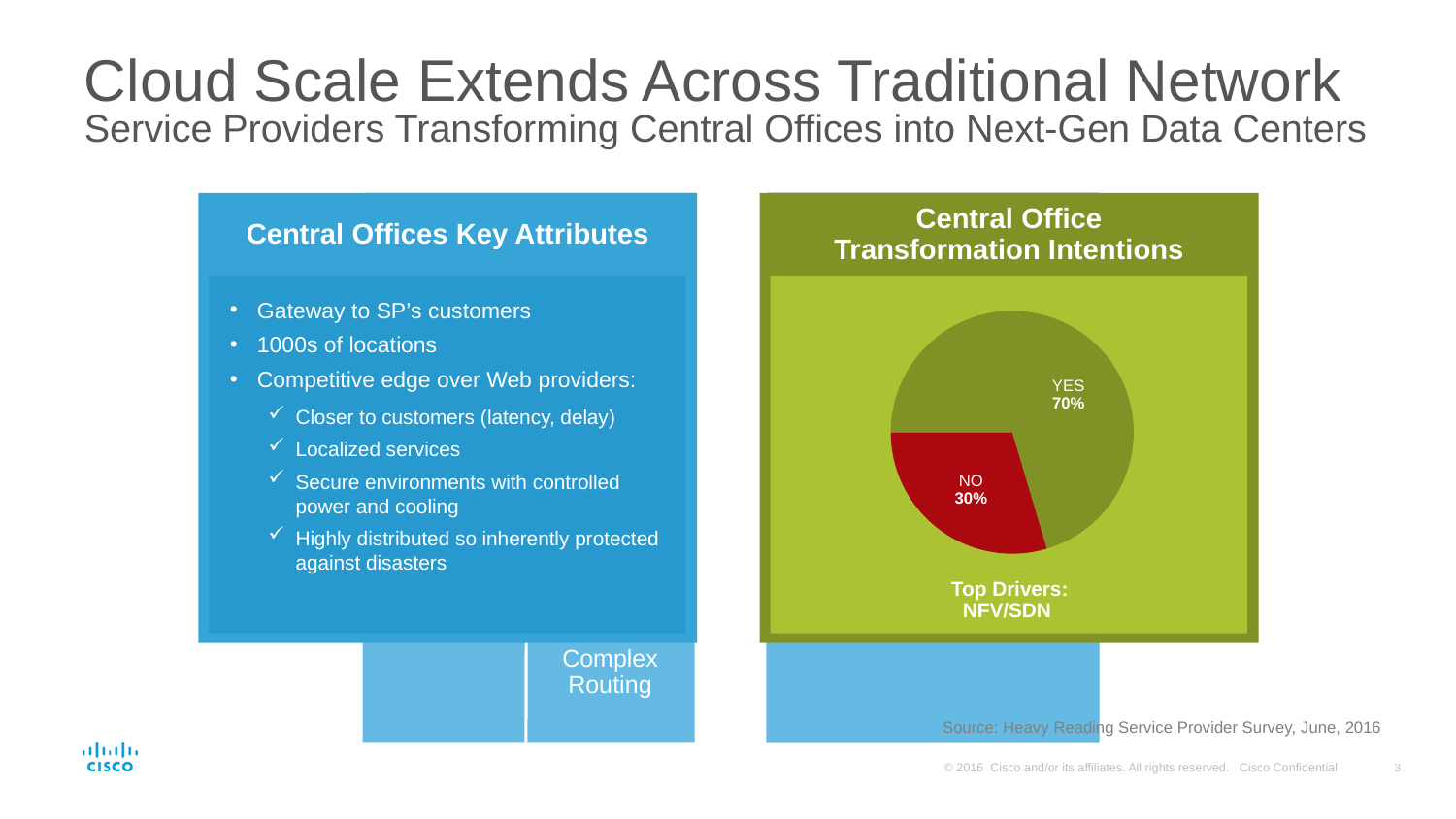
What is the title of the panel containing the pie chart? Central Office Transformation Intentions What is the difference in percentage points between the YES and NO slices? 40 Which slice of the pie chart is the largest? YES How many slices does the pie chart have? 2 What type of chart is shown under "Central Office Transformation Intentions"? pie chart What percentage of the pie chart is labelled YES? 70% What share of the pie does the NO slice represent? 30% What percentage of the pie chart is labelled NO? 30% Which is larger in the pie chart, YES or NO? YES Which slice of the pie chart is the smallest? NO What colour is the NO slice of the pie chart? red